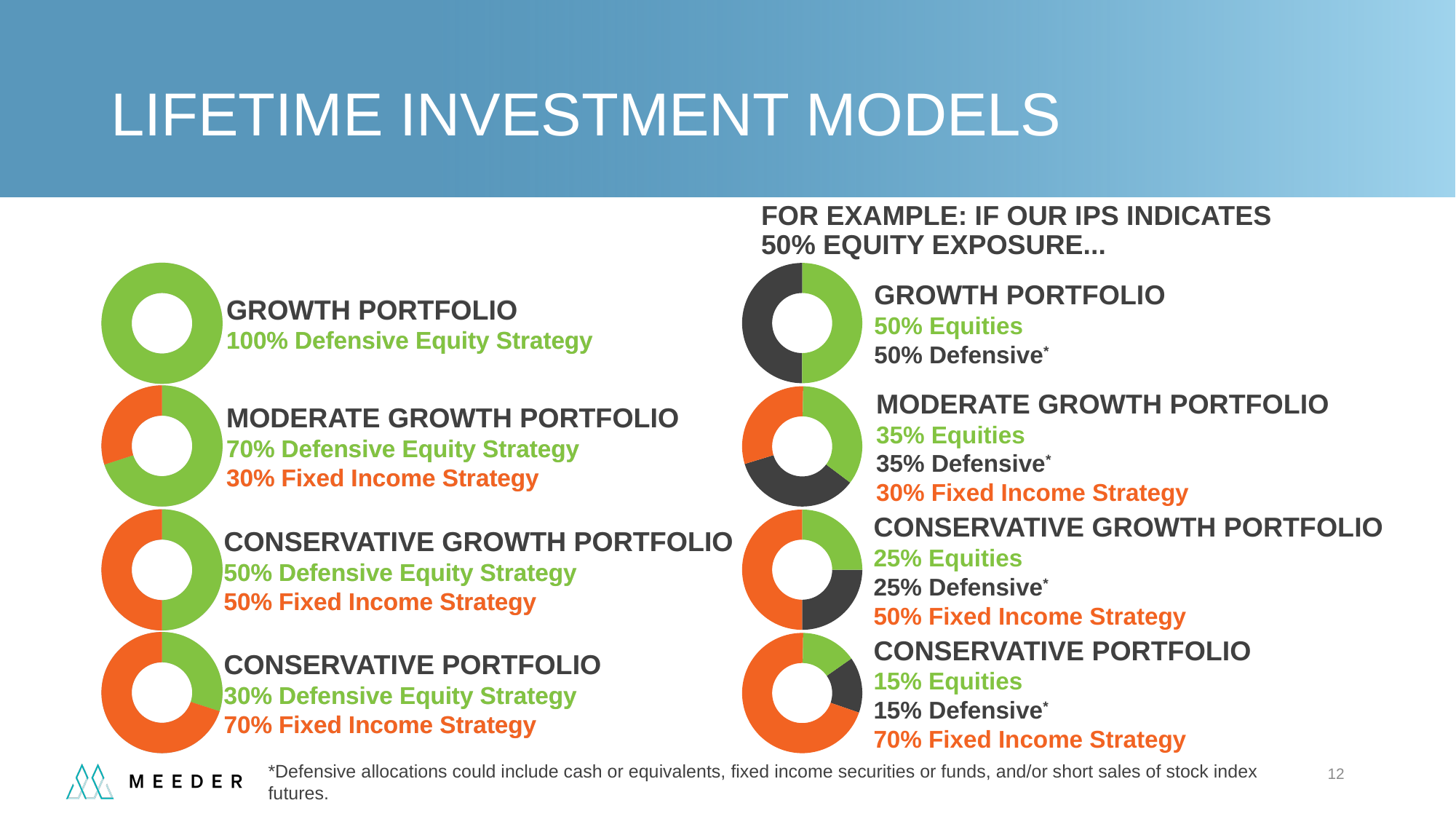
In the right-hand Conservative Growth Portfolio chart, what is the difference between the Fixed Income Strategy share and the Equities share? 25% Which colour represents the Fixed Income Strategy in the charts? Orange In the left-hand Moderate Growth Portfolio chart, what share is the Fixed Income Strategy? 30% In the left-hand Conservative Portfolio chart, what share is the Defensive Equity Strategy? 30% In the right-hand Conservative Portfolio chart, what share is the Fixed Income Strategy? 70% How many slices does the right-hand Growth Portfolio chart have? 2 What kind of charts are shown on the slide? Donut (pie) charts In the right-hand Moderate Growth Portfolio chart, what share is Equities? 35% In the right-hand Conservative Portfolio chart, which is larger, Equities or Fixed Income Strategy? Fixed Income Strategy In the left-hand Growth Portfolio chart, what share is the Defensive Equity Strategy? 100% In the left-hand Conservative Portfolio chart, what is the difference between the Fixed Income Strategy share and the Defensive Equity Strategy share? 40% How many slices does the right-hand Moderate Growth Portfolio chart have? 3